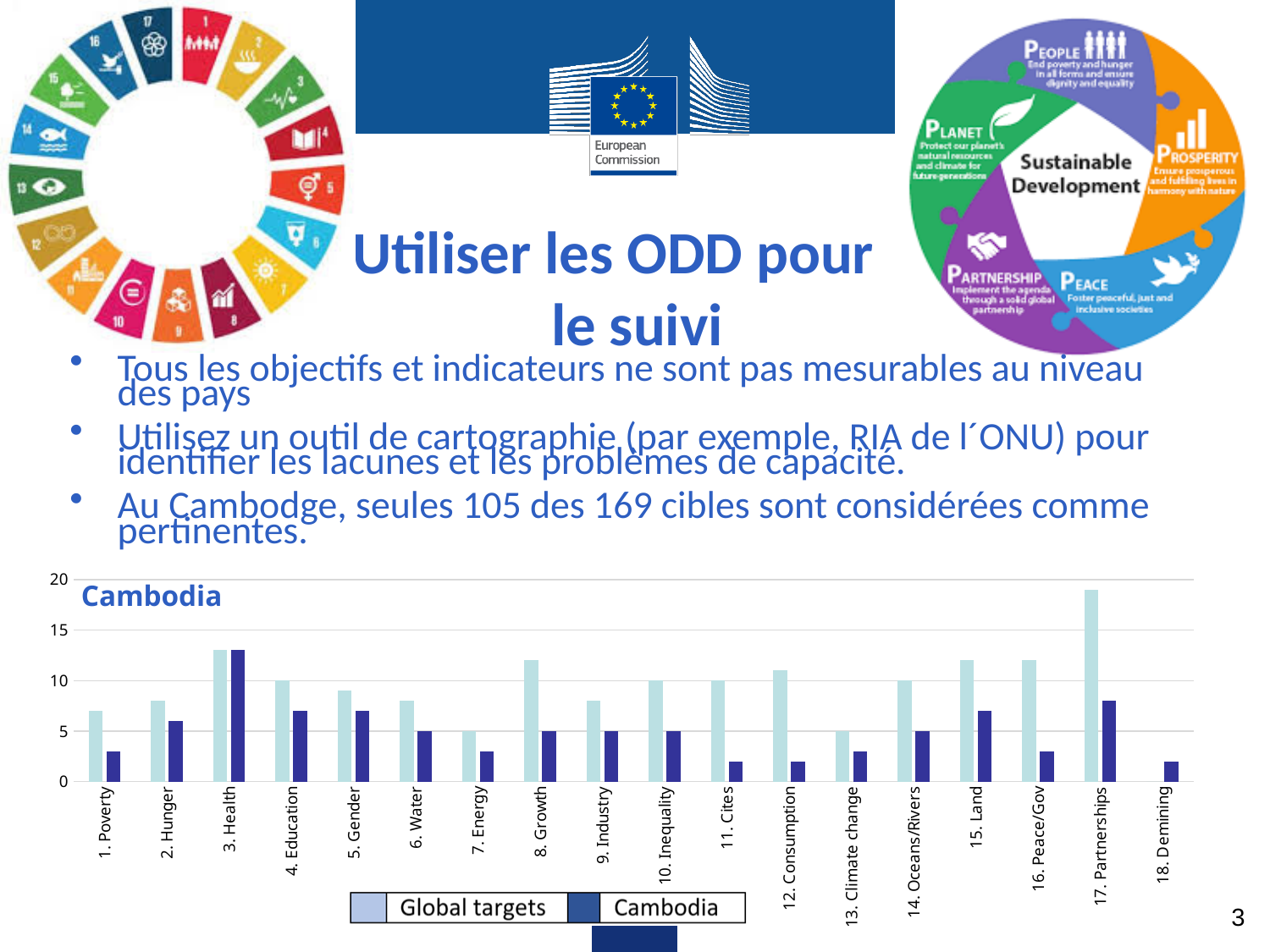
Which category has the highest Cambodia value in the Cambodia chart? 3. Health How many series does the legend of the Cambodia chart list? 2 Is the Global targets value for 17. Partnerships greater or less than 15? greater Is the Global targets value for 12. Consumption greater or less than 10? greater What is the title of the chart at the bottom of the slide? Cambodia Is the Cambodia value for 1. Poverty greater or less than 5? less How many categories are shown on the x axis of the Cambodia chart? 18 Which category has the highest Global targets value in the Cambodia chart? 17. Partnerships For 17. Partnerships, which is larger: the Global targets value or the Cambodia value? Global targets For 15. Land, which is larger: the Global targets value or the Cambodia value? Global targets What kind of chart is shown at the bottom of the slide? bar chart